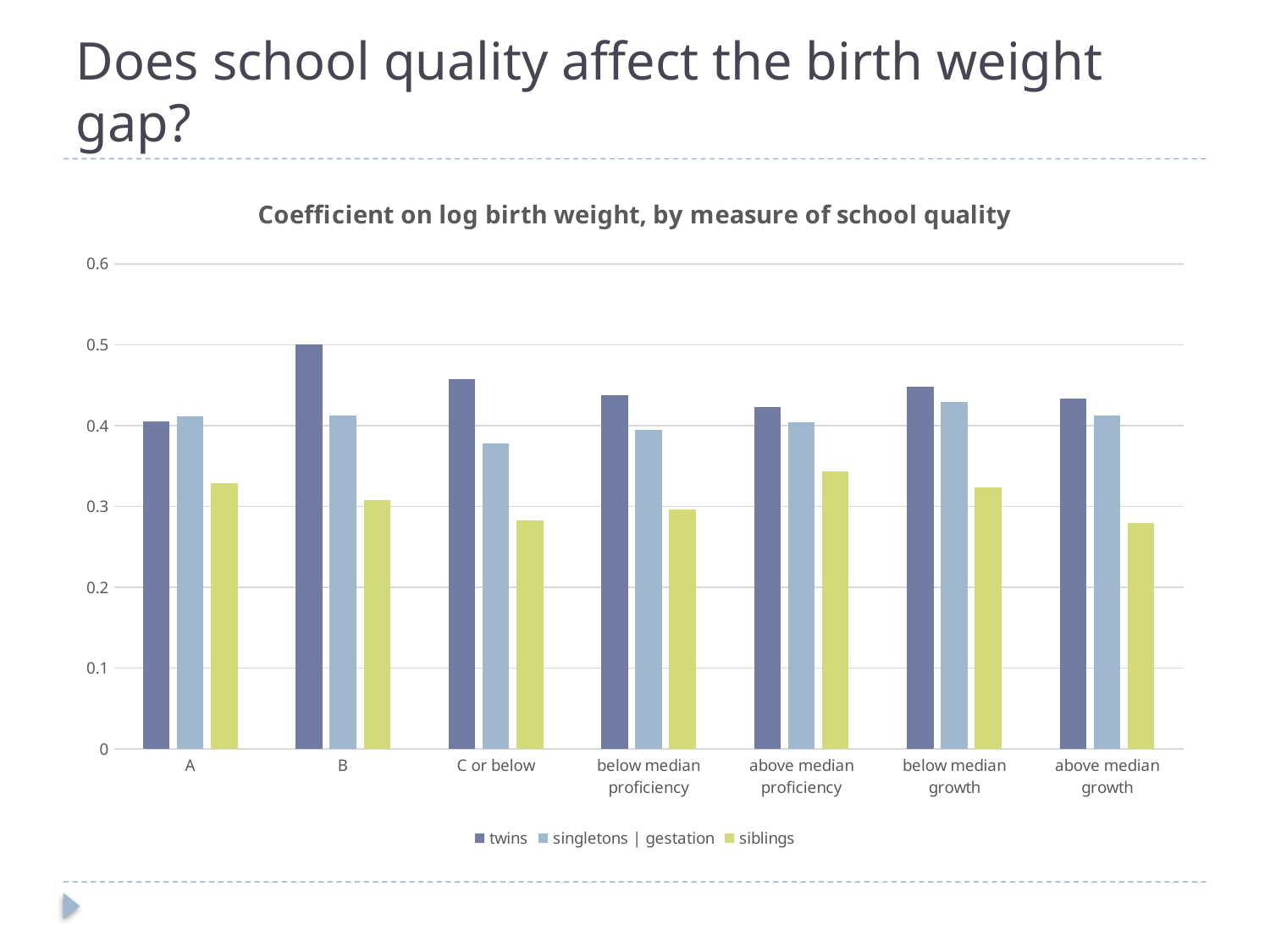
What kind of chart is shown on the slide? bar chart For C or below, which is larger: the twins value or the singletons | gestation value? twins Which category has the lowest value for the singletons | gestation series? C or below Is the singletons | gestation value for C or below greater or less than 0.4? less For category B, which is larger: the twins value or the siblings value? twins What is the title of the chart? Coefficient on log birth weight, by measure of school quality Is the siblings value for C or below greater or less than 0.3? less Is the twins value for B greater or less than 0.4? greater How many categories are shown on the x axis? 7 Which category has the highest value for the twins series? B How many series does the legend list? 3